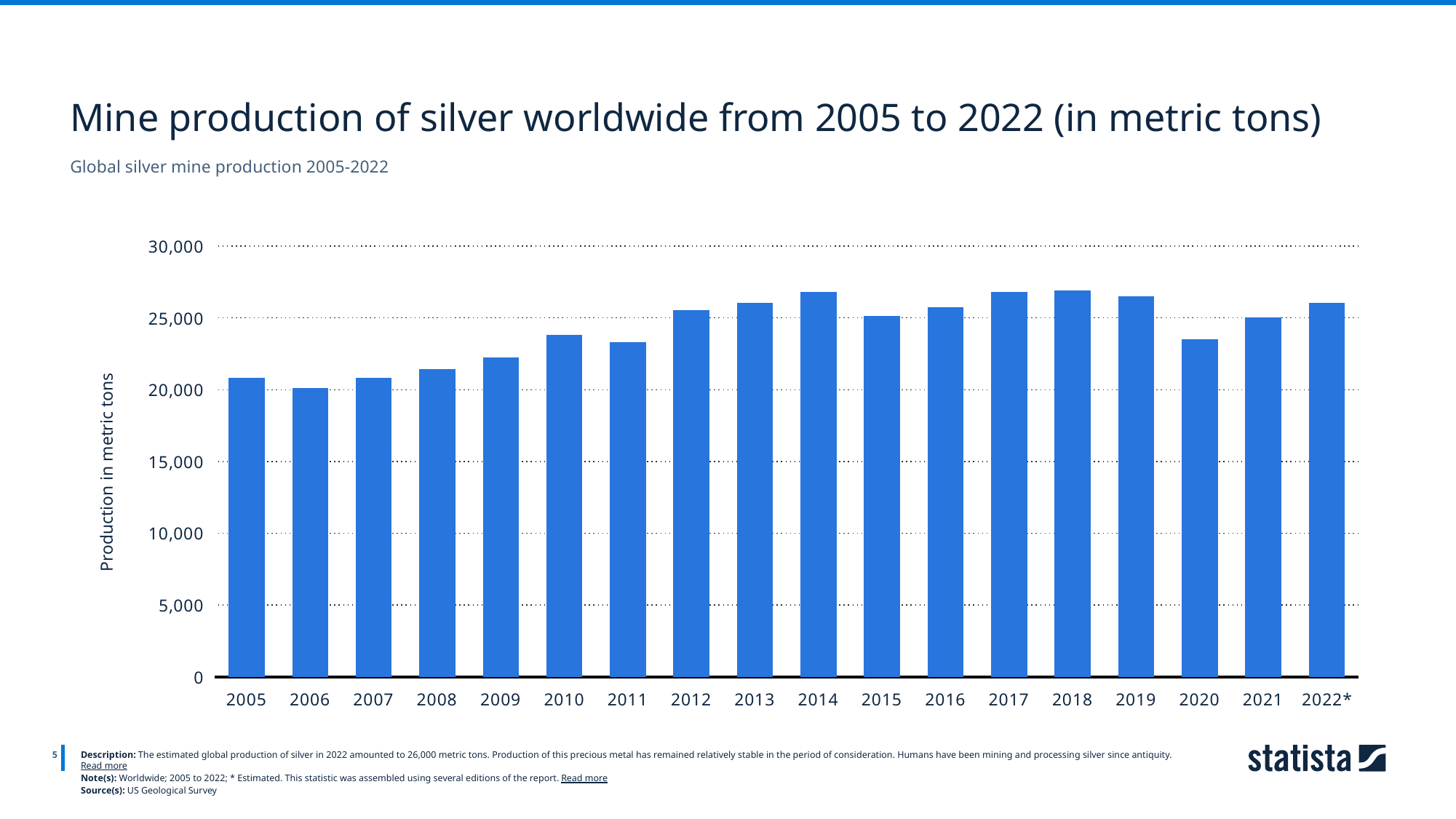
Is the value for 2006 greater or less than 25,000? less Is the value for 2010 greater or less than 20,000? greater Which year has the larger value, 2009 or 2012? 2012 What kind of chart is shown on the slide? bar chart Which year has the lowest silver mine production in the chart? 2006 What does the asterisk on 2022* indicate, according to the note? Estimated Is the value for 2014 greater or less than 25,000? greater Do the values rise or fall from 2006 to 2014? rise How many years (bars) are plotted in the chart? 18 What is the label of the y-axis? Production in metric tons Which year has the larger value, 2019 or 2020? 2019